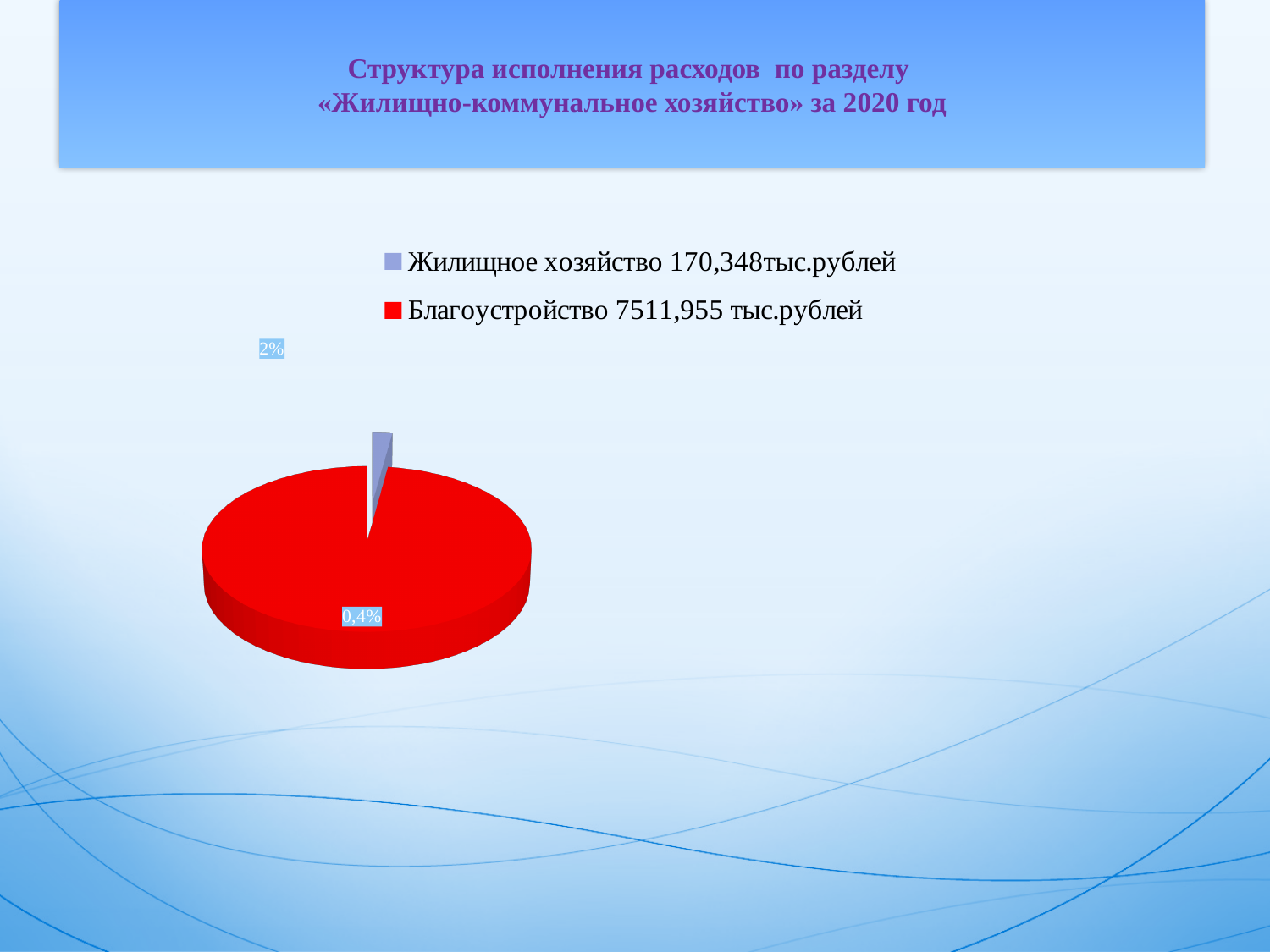
How many entries does the legend of the pie chart list? 2 What percentage label is printed next to the small blue slice? 2% Which category has the smallest slice of the pie? Жилищное хозяйство According to the legend, what is the value for Благоустройство? 7511,955 тыс.рублей Which is larger, the slice for Жилищное хозяйство or the slice for Благоустройство? Благоустройство According to the legend, what is the value for Жилищное хозяйство? 170,348 тыс.рублей Which category has the largest slice of the pie? Благоустройство How many slices does the pie chart have? 2 What kind of chart is shown on the slide? pie chart What colour is the slice for Благоустройство? red What year does the slide title say the chart covers? 2020 What percentage label is printed on the red slice? 0,4%